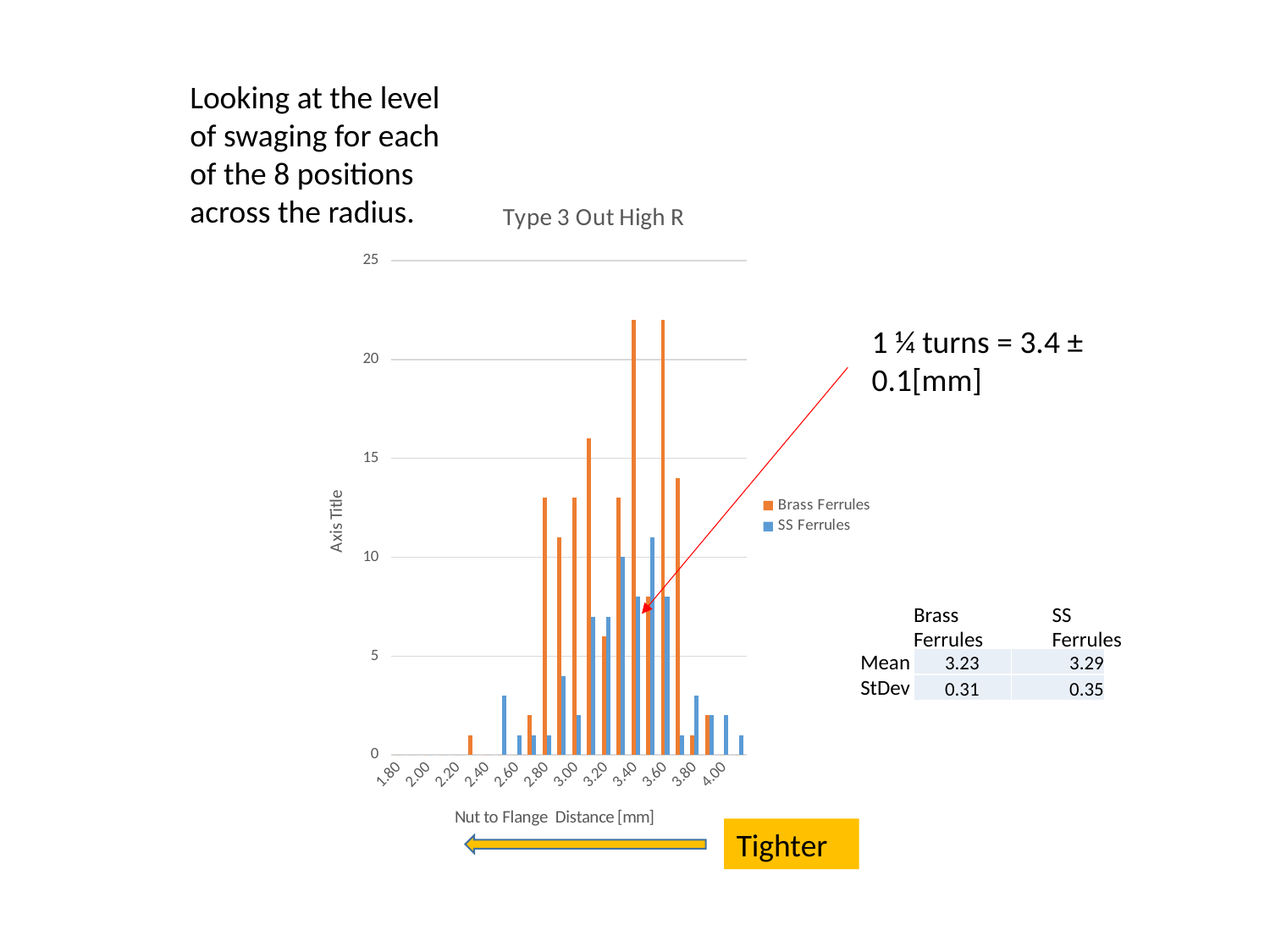
What are the two series named in the chart's legend? Brass Ferrules and SS Ferrules Is the SS Ferrules bar near 3.60 on the x axis greater or less than 5? greater Which series has the tallest bar in the chart, Brass Ferrules or SS Ferrules? Brass Ferrules Is the tallest SS Ferrules bar greater or less than 10? greater Is the Brass Ferrules bar near 3.80 on the x axis greater or less than 5? less What is the title of the chart? Type 3 Out High R What kind of chart is shown on the slide? bar chart How many series does the chart's legend list? 2